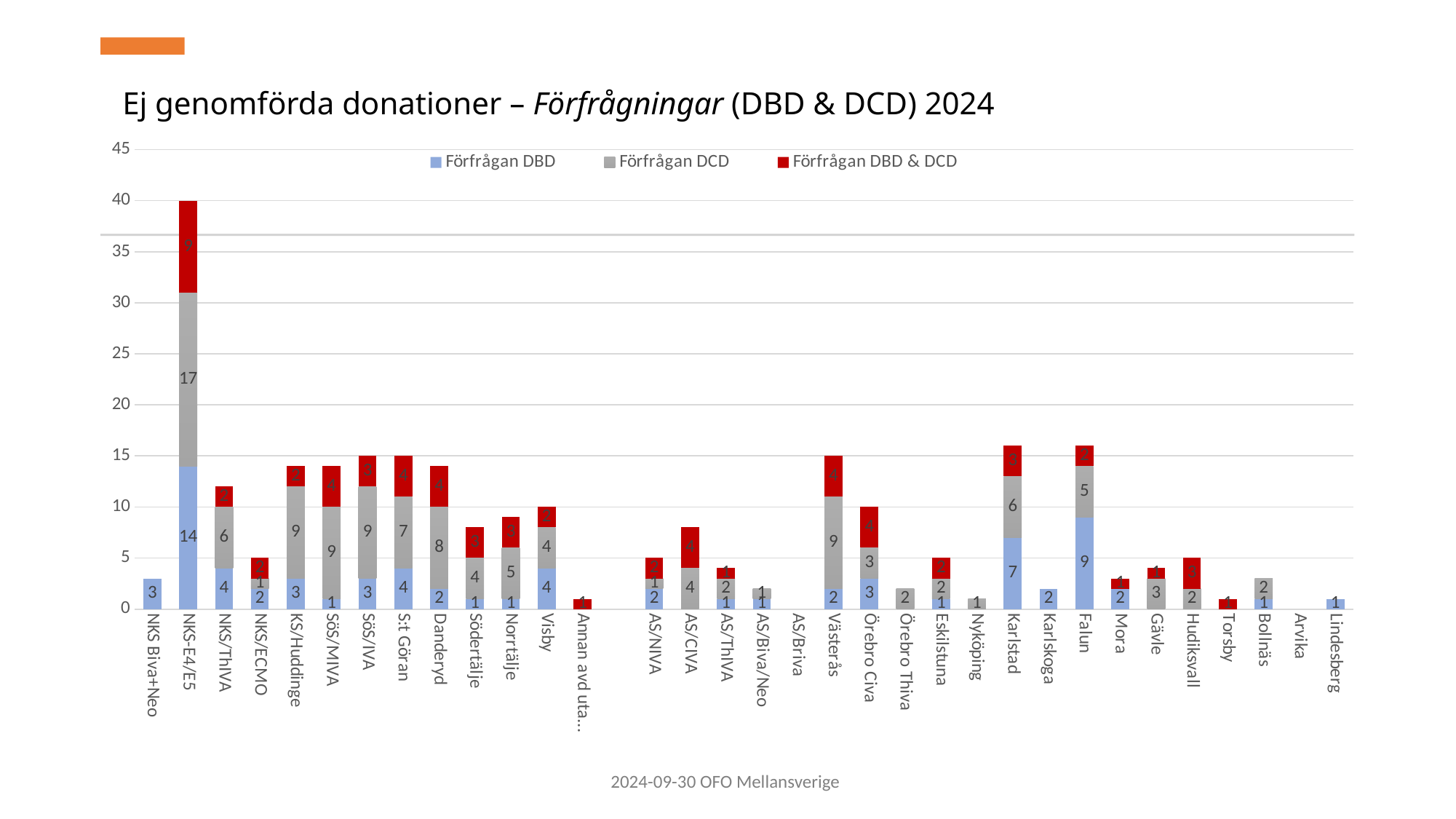
How many series does the legend list? 3 Which series is shown in red in the legend? Förfrågan DBD & DCD Which is larger, the Förfrågan DBD value for Falun or for NKS/ThIVA? Falun What type of chart is shown on the slide? Stacked bar chart Is the total stacked bar for NKS-E4/E5 greater or less than 35? greater What is the Förfrågan DCD value for NKS-E4/E5? 17 What is the difference between the Förfrågan DCD values for NKS-E4/E5 and KS/Huddinge? 8 What is the total of the stacked bar for S:t Göran? 15 What is the Förfrågan DBD & DCD value for Västerås? 4 What is the total of the stacked bar for Falun? 16 Which category has the highest total stacked bar? NKS-E4/E5 What is the Förfrågan DBD value for Karlstad? 7